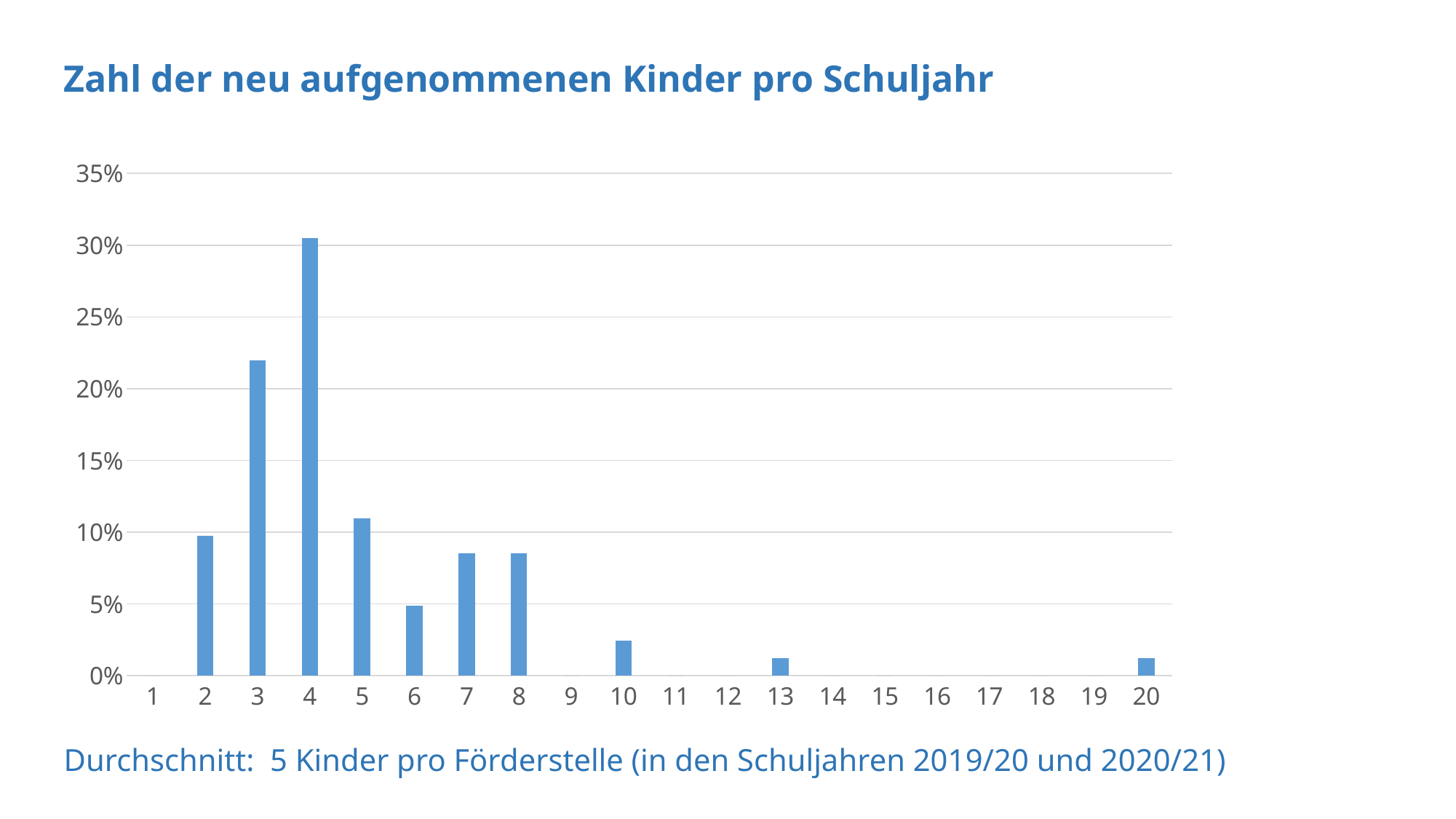
Is the value for category 4 greater or less than 25%? greater Which is larger, the value for category 2 or category 6? 2 Is the value for category 5 greater or less than 15%? less Which is larger, the value for category 3 or category 5? 3 Which category has the highest bar? 4 What is the title of the chart? Zahl der neu aufgenommenen Kinder pro Schuljahr How many categories have a visible bar? 10 How many categories are labelled on the x axis? 20 Is the value for category 7 greater or less than 10%? less What kind of chart is shown on the slide? bar chart